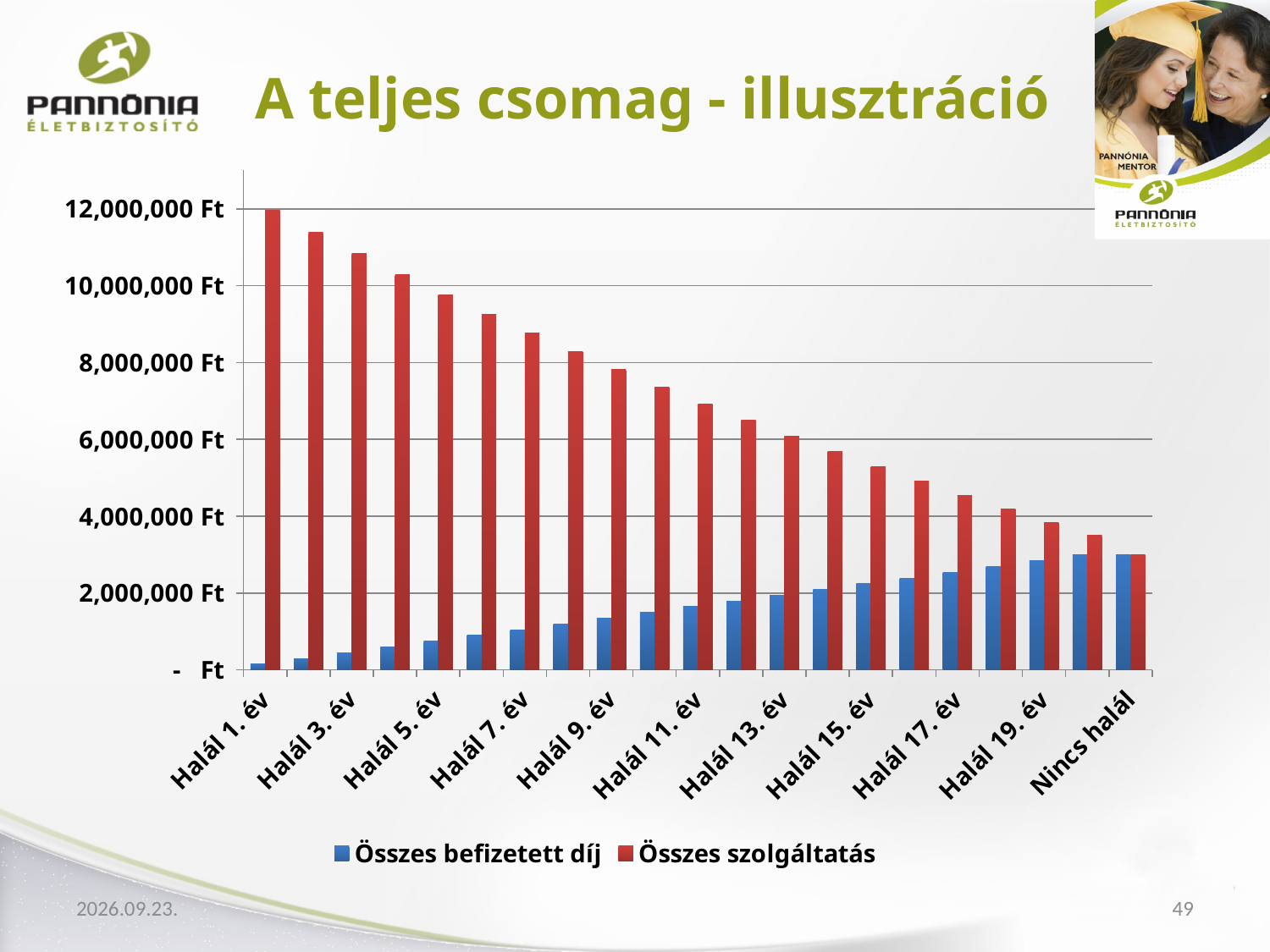
Is the Összes befizetett díj value for Halál 1. év greater or less than 2,000,000 Ft? less Is the Összes szolgáltatás value for Halál 11. év greater or less than 6,000,000 Ft? greater What is the title of the slide's chart? A teljes csomag - illusztráció Is the Összes szolgáltatás value for Halál 1. év greater or less than 10,000,000 Ft? greater For which category is Összes szolgáltatás highest? Halál 1. év Does the Összes szolgáltatás series rise or fall from Halál 1. év to Nincs halál? fall For Halál 19. év, which is larger: Összes befizetett díj or Összes szolgáltatás? Összes szolgáltatás What kind of chart is shown on the slide? bar chart How many series does the legend list? 2 For which category is Összes befizetett díj lowest? Halál 1. év Which colour represents the Összes szolgáltatás series? red